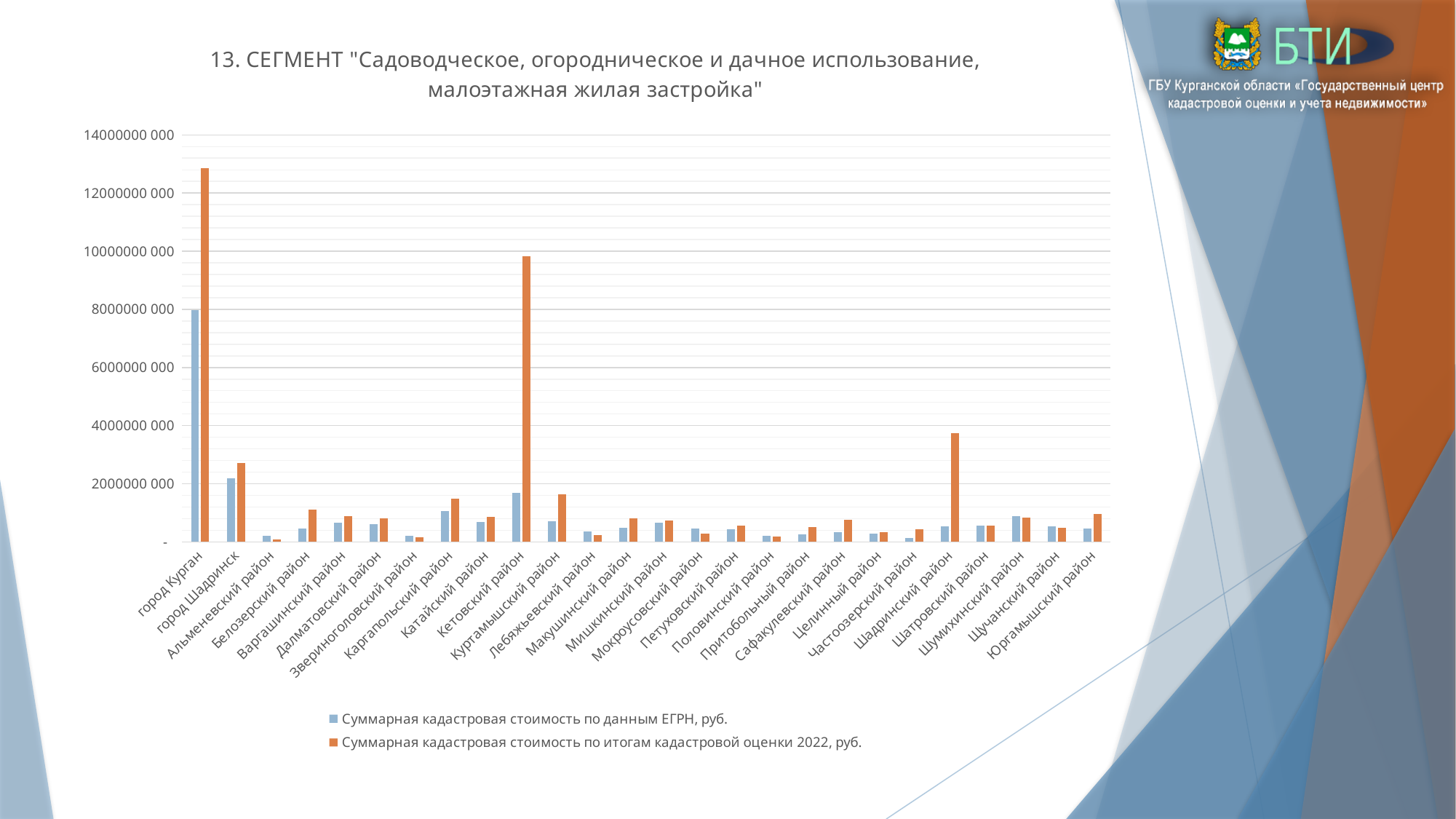
What kind of chart is shown on the slide? bar chart In the series "Суммарная кадастровая стоимость по итогам кадастровой оценки 2022, руб.", which is larger: Кетовский район or Шадринский район? Кетовский район What colour are the bars for the series "Суммарная кадастровая стоимость по итогам кадастровой оценки 2022, руб."? orange Which category has the highest value for the series "Суммарная кадастровая стоимость по итогам кадастровой оценки 2022, руб."? город Курган Is the value for город Шадринск in the series "Суммарная кадастровая стоимость по итогам кадастровой оценки 2022, руб." greater or less than 2000000 000? greater How many series does the legend list? 2 Which category has the highest value for the series "Суммарная кадастровая стоимость по данным ЕГРН, руб."? город Курган For город Курган, which series has the larger value: "Суммарная кадастровая стоимость по данным ЕГРН, руб." or "Суммарная кадастровая стоимость по итогам кадастровой оценки 2022, руб."? Суммарная кадастровая стоимость по итогам кадастровой оценки 2022, руб. Is the value for Кетовский район in the series "Суммарная кадастровая стоимость по итогам кадастровой оценки 2022, руб." greater or less than 8000000 000? greater How many categories are plotted along the x axis? 26 Is the value for город Курган in the series "Суммарная кадастровая стоимость по итогам кадастровой оценки 2022, руб." greater or less than 12000000 000? greater